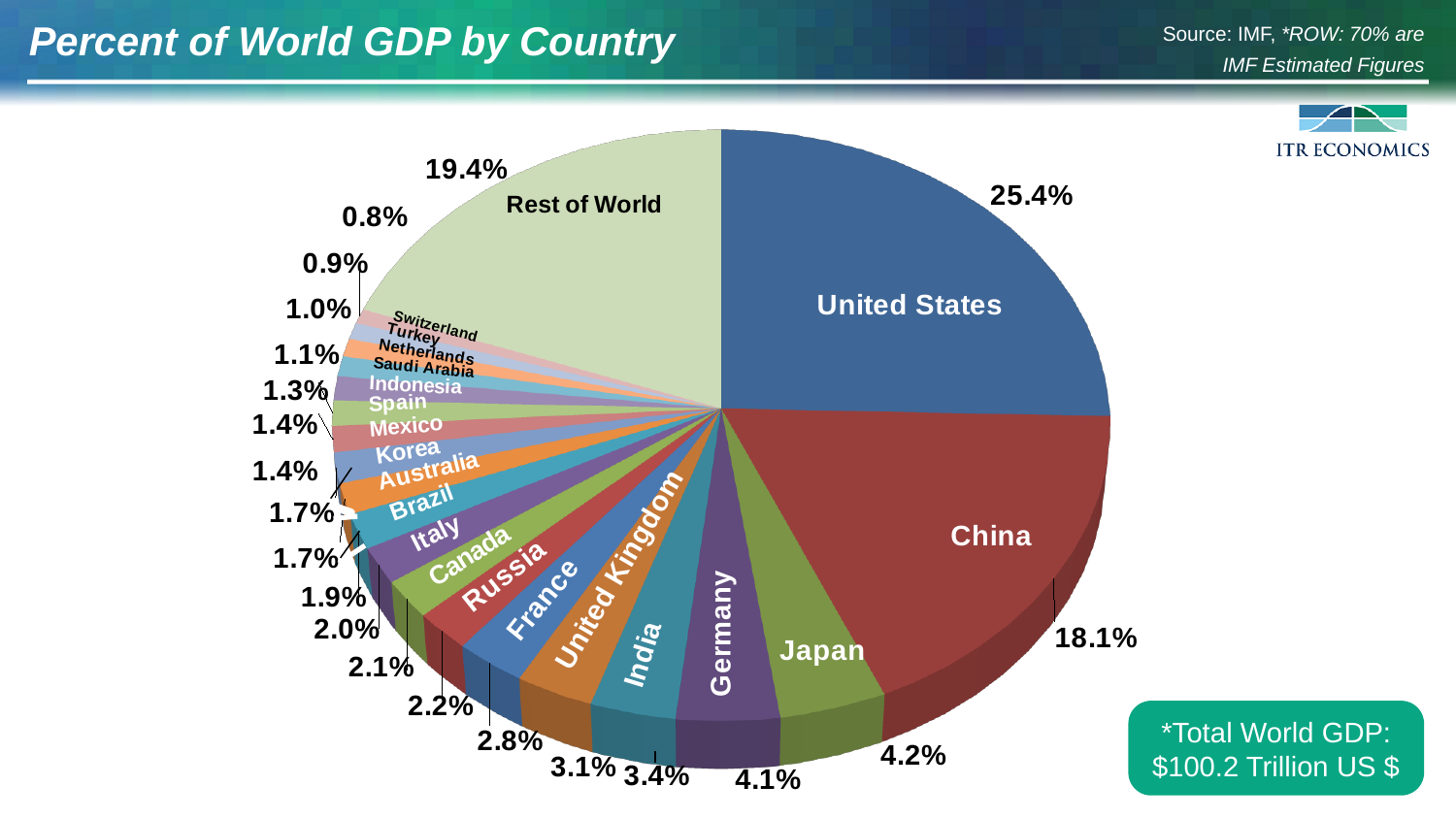
What is the smallest percentage value shown on the chart? 0.8% How many slices does the pie chart have? 21 What share of world GDP is attributed to the Rest of World slice? 19.4% What is Germany's percent of world GDP? 4.1% What is Japan's percent of world GDP? 4.2% What percent of world GDP does the United States account for? 25.4% How many percentage points larger is the United States' share than China's? 7.3 percentage points Which country has the largest share of world GDP? United States Which has a larger share of world GDP, Japan or Germany? Japan What is the title of the chart? Percent of World GDP by Country What kind of chart is shown on the slide? pie chart What percent of world GDP does China account for? 18.1%